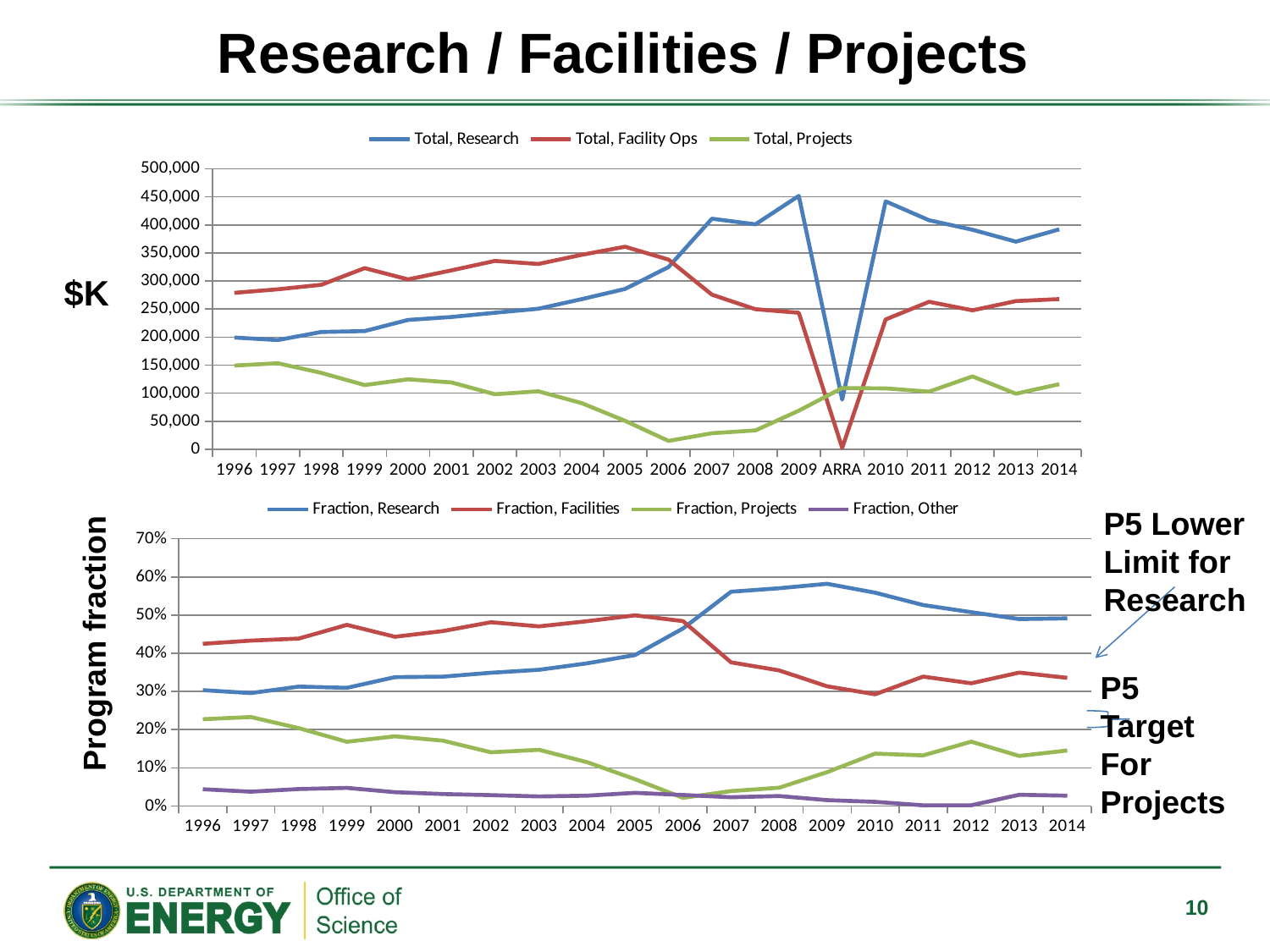
In the bottom chart, which series has the lowest value in 2014? Fraction, Other In the bottom chart, does Fraction, Research rise or fall from 2009 to 2013? fall What kind of chart is the top chart (Total, Research / Facility Ops / Projects)? line chart What is the y-axis label of the bottom chart? Program fraction In the top chart, is the value for Total, Facility Ops at ARRA greater or less than 50,000? less In the bottom chart, which is larger in 2009: Fraction, Research or Fraction, Facilities? Fraction, Research How many series does the legend of the top chart list? 3 In the top chart, which series has the highest value in 2005? Total, Facility Ops In the bottom chart, is the value for Fraction, Projects in 2006 greater or less than 10%? less How many series does the legend of the bottom chart (Program fraction) list? 4 In the top chart, is the value for Total, Research in 2009 greater or less than 400,000? greater How many x-axis labels (years plus ARRA) does the top chart show? 20